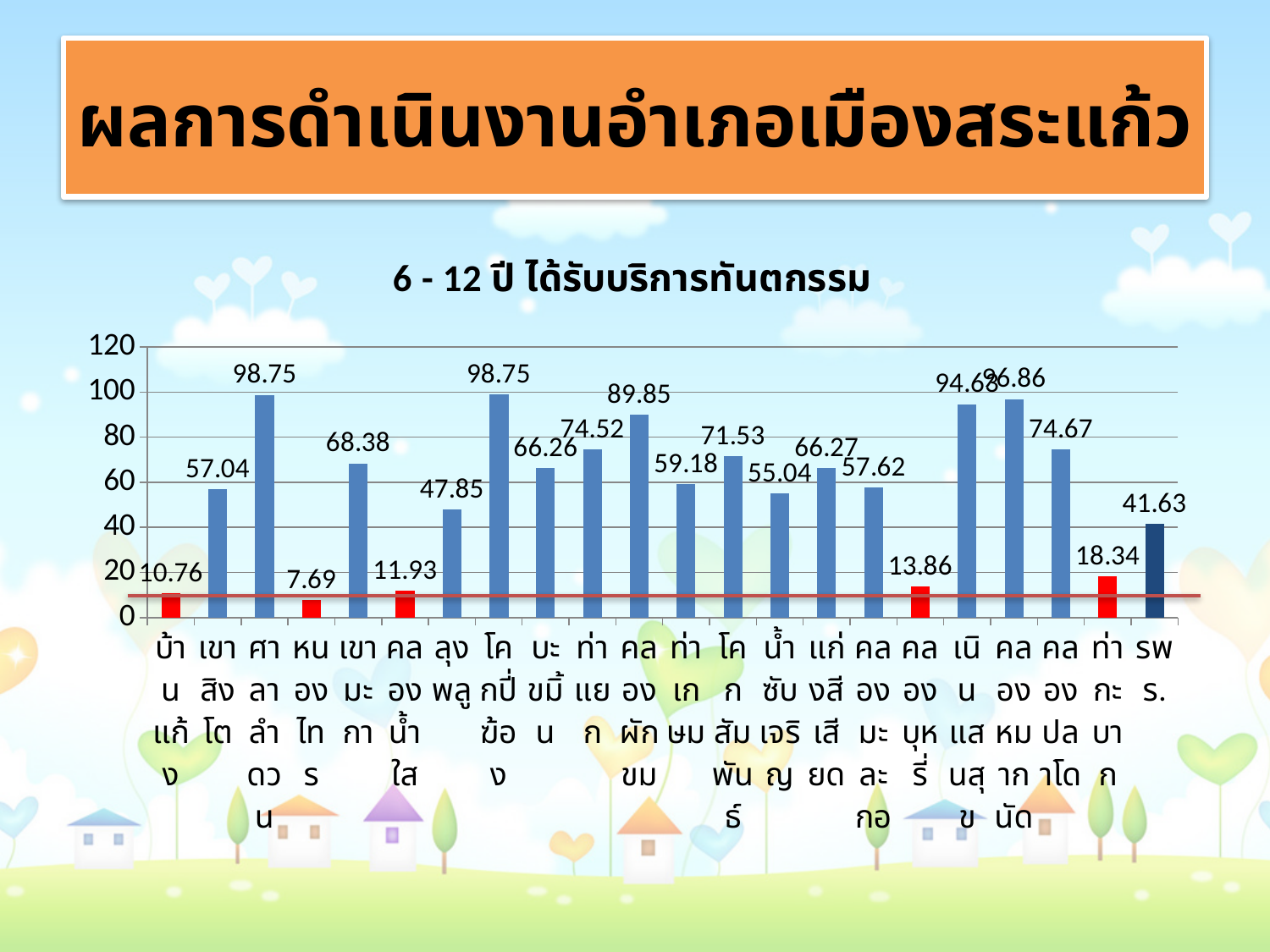
What is the value for ท่าเกษม? 59.18 How many categories are shown on the chart? 22 What is the title of the chart? 6 - 12 ปี ได้รับบริการทันตกรรม What is the difference between the values for ท่าแยก and ท่าเกษม? 15.34 What is the highest value shown on the chart? 98.75 Is the value for เขาสิงโต greater or less than 40? greater Which category has the lowest value? หนองไทร What kind of chart is shown on the slide? bar chart What is the value for ลุงพลู? 47.85 What is the value for บ้านแก้ง? 10.76